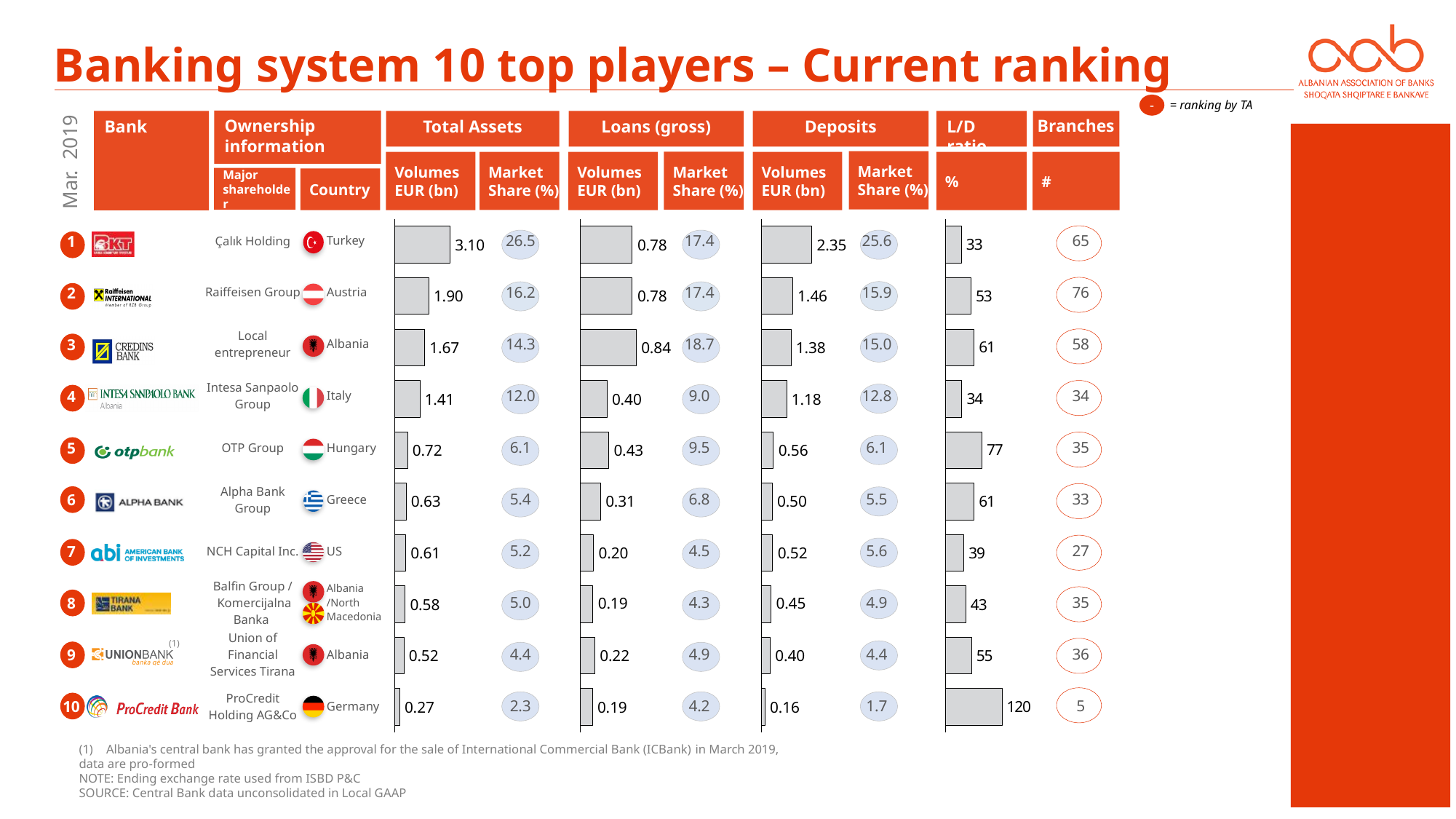
In the L/D ratio chart, which is larger: OTP Bank (rank 5) or Credins Bank (rank 3)? OTP Bank In the L/D ratio chart, what is the value for ProCredit Bank (rank 10)? 120 What kind of chart is used to show the Total Assets volumes? Bar chart In the Loans (gross) volumes chart, what is the value for Intesa Sanpaolo Bank Albania (rank 4)? 0.40 In the Total Assets volumes chart, what is the difference between BKT (3.10) and Raiffeisen (1.90)? 1.20 In the Total Assets volumes chart, what is the value for Credins Bank (rank 3)? 1.67 In the Total Assets volumes chart, which bank has the highest value? BKT (rank 1) In the Deposits volumes chart, what is the value for OTP Bank (rank 5)? 0.56 How many banks (bars) are shown in the Total Assets volumes chart? 10 In the L/D ratio chart, which bank has the highest value? ProCredit Bank (rank 10) In the Deposits volumes chart, which bank has the lowest value? ProCredit Bank (rank 10) In the Total Assets volumes chart, do the values rise or fall going from rank 1 down to rank 10? Fall